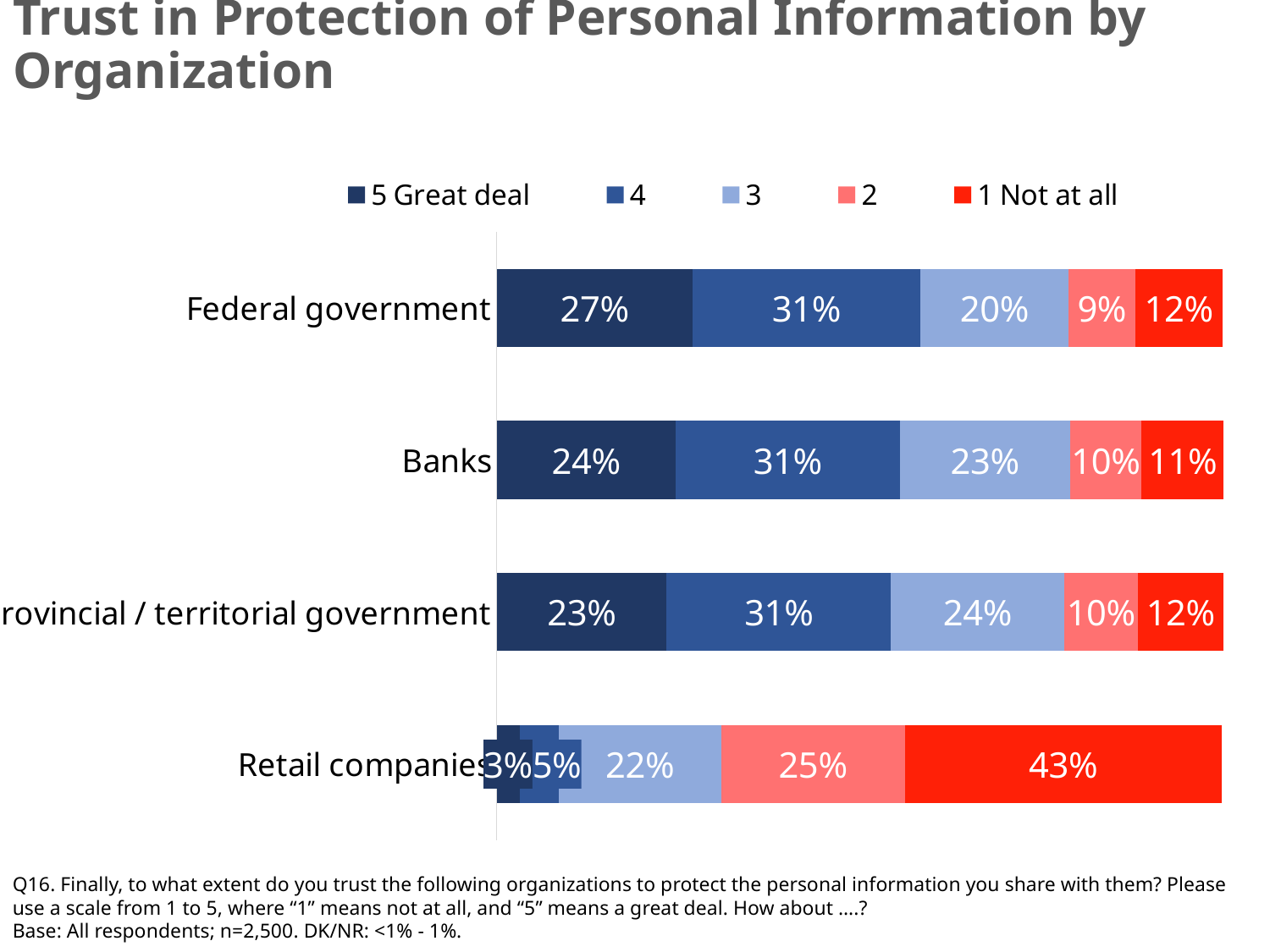
What is the value for Retail companies in the '2' series? 25% How many organizations are shown in the chart? 4 What is the difference between the '5 Great deal' values for the Federal government and Banks? 3% What is the total of the stacked bar for Retail companies? 98% What is the value for Banks in the '3' series? 23% Which organization has the lowest '5 Great deal' value? Retail companies Which organization has the highest '1 Not at all' value? Retail companies What kind of chart is shown on the slide? Stacked bar chart Which is larger: the '3' value for the Federal government or the '3' value for Banks? Banks What percentage of respondents trust the Federal government a great deal (5)? 27% What percentage of respondents do not trust Retail companies at all (1)? 43% How many series does the legend list? 5